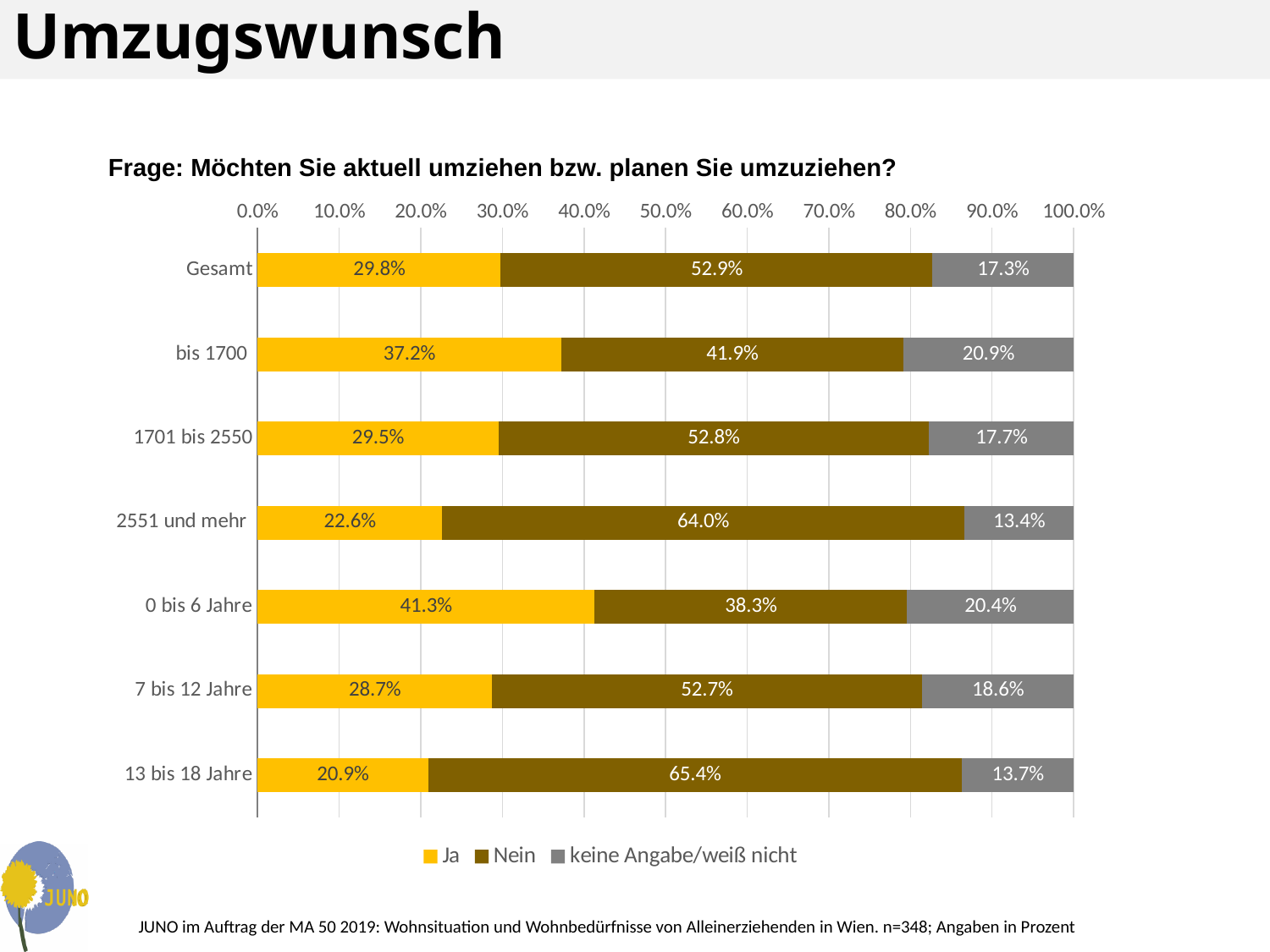
What are the three legend entries of the chart? Ja, Nein, keine Angabe/weiß nicht How many categories (bars) are shown in the chart? 7 What kind of chart is shown on the slide? Stacked bar chart Which category has the highest "Ja" value? 0 bis 6 Jahre Which category has the lowest "Ja" value? 13 bis 18 Jahre What is the value of the "Nein" segment for "2551 und mehr"? 64.0% How many series does the legend list? 3 Which category has the highest "Nein" value? 13 bis 18 Jahre What is the value of the "Ja" segment for the "Gesamt" bar? 29.8% For the "Gesamt" bar, how much larger is the "Nein" value than the "Ja" value? 23.1 percentage points Which has the larger "Ja" value: "bis 1700" or "2551 und mehr"? bis 1700 What is the value of the "keine Angabe/weiß nicht" segment for "0 bis 6 Jahre"? 20.4%